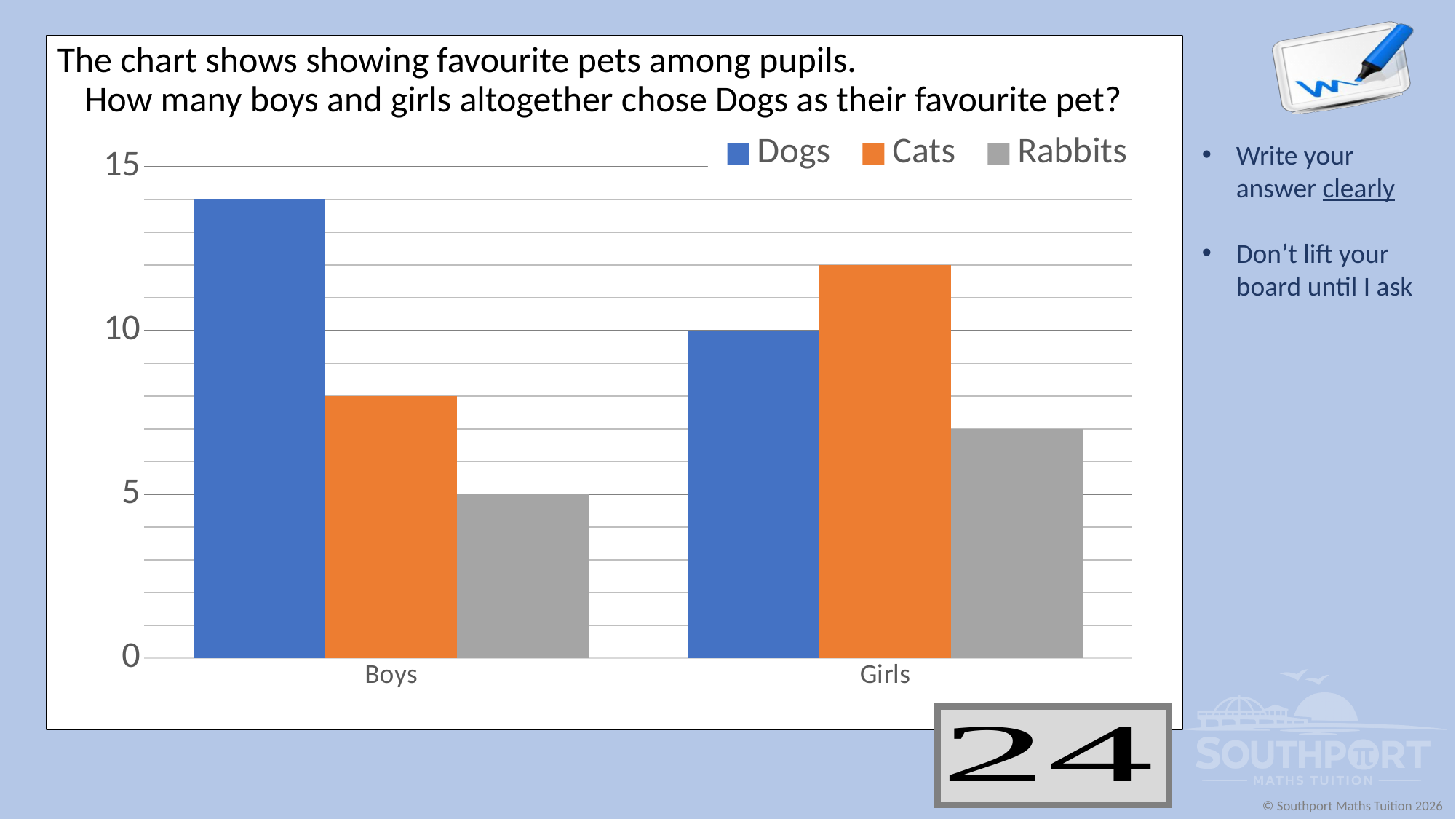
Which pet has the highest value in the Boys category? Dogs What is the value for Dogs in the Girls category? 10 Which is larger: Dogs for Boys or Dogs for Girls? Dogs for Boys Is the value for Cats in the Boys category greater or less than 10? less What kind of chart is shown on the slide? bar chart What is the value for Rabbits in the Boys category? 5 How many categories are shown on the x axis? 2 How many series does the legend list? 3 Is the value for Rabbits in the Girls category greater or less than 5? greater Is the value for Cats in the Girls category greater or less than 10? greater Which pet has the lowest value in the Girls category? Rabbits